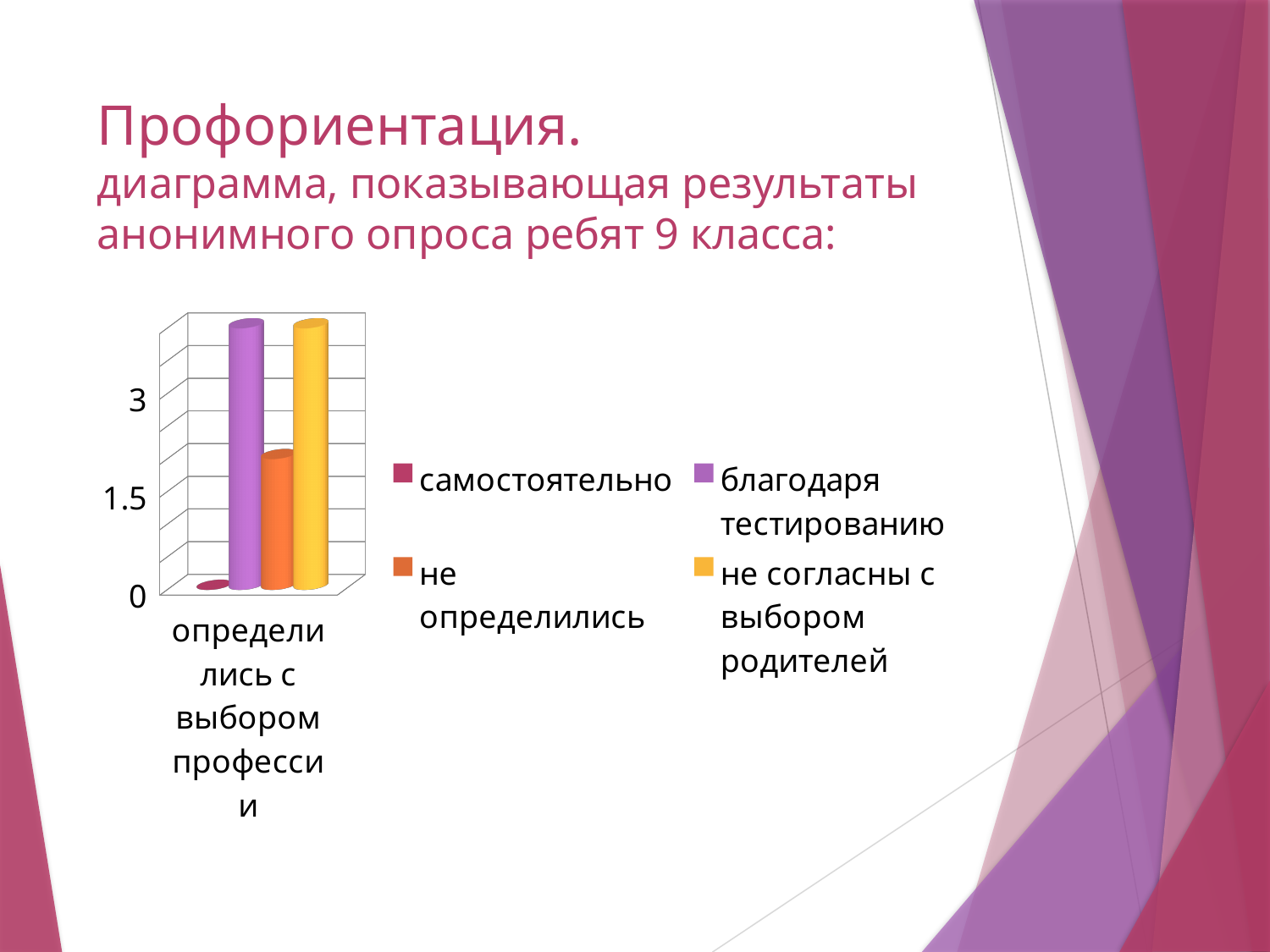
Which is larger: the value for "благодаря тестированию" or the value for "не определились"? благодаря тестированию Which is larger: the value for "не определились" or the value for "самостоятельно"? не определились Is the value for "не согласны с выбором родителей" greater or less than 3? greater Is the value for "самостоятельно" greater or less than 1.5? less What kind of chart is shown on the slide? bar chart Is the value for "не определились" greater or less than 1.5? greater How many series does the chart legend list? 4 What is the label of the single category on the x axis of the chart? определились с выбором профессии How many categories are shown on the x axis of the chart? 1 Which series has the lowest value in the chart? самостоятельно